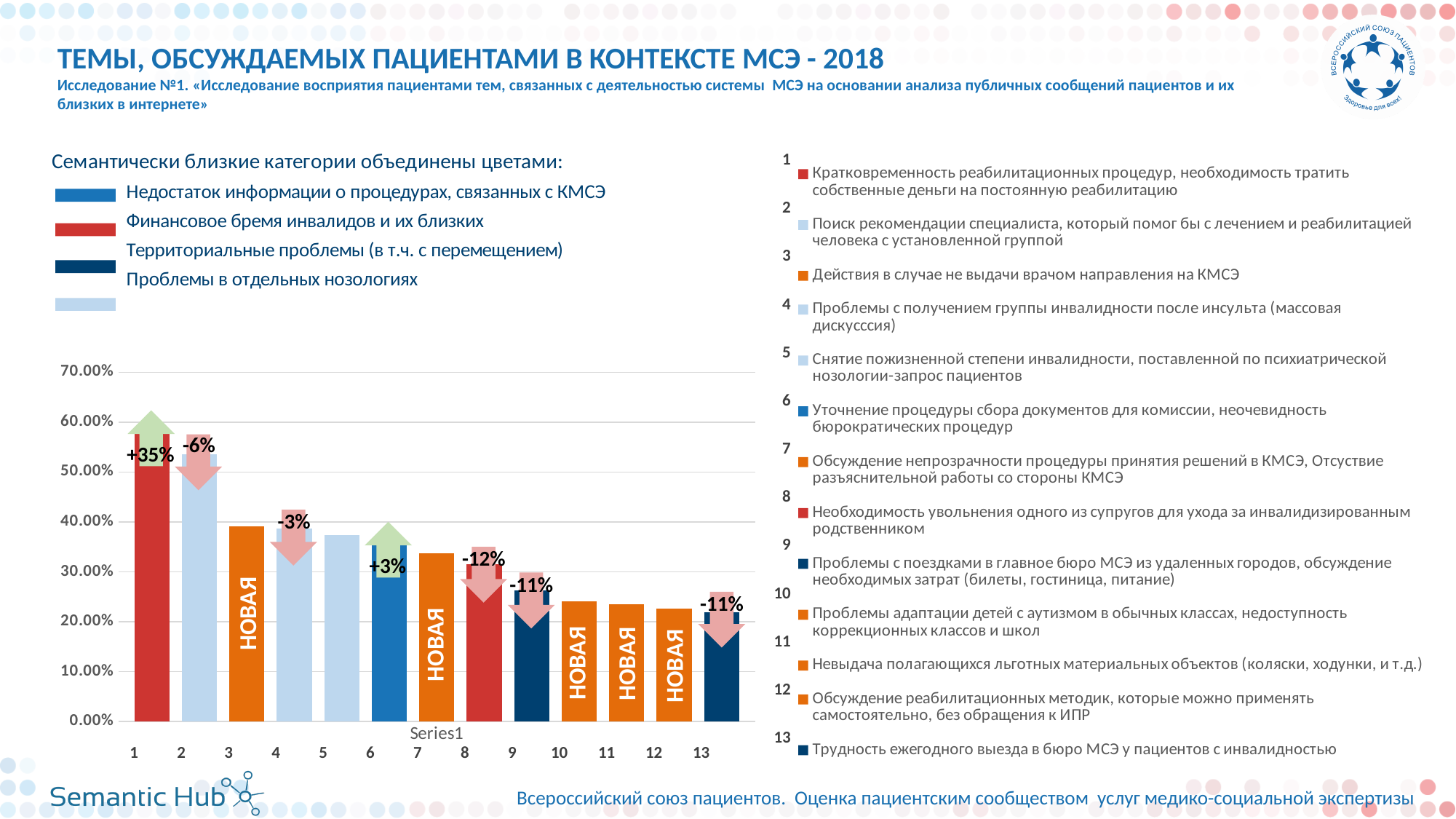
What change annotation is printed above the bar for category 1? +35% How many bars in the chart are labelled "НОВАЯ"? 5 What kind of chart is shown on the slide? bar chart Do the bar values generally rise or fall from category 1 to category 13? fall Is the value for category 9 greater or less than 20%? greater How many bars (categories) are plotted in the chart? 13 Is the value for category 1 greater or less than 50%? greater Is the value for category 5 greater or less than 40%? less Which category has the tallest bar in the chart? 1 Which is larger, the value for category 1 or the value for category 9? category 1